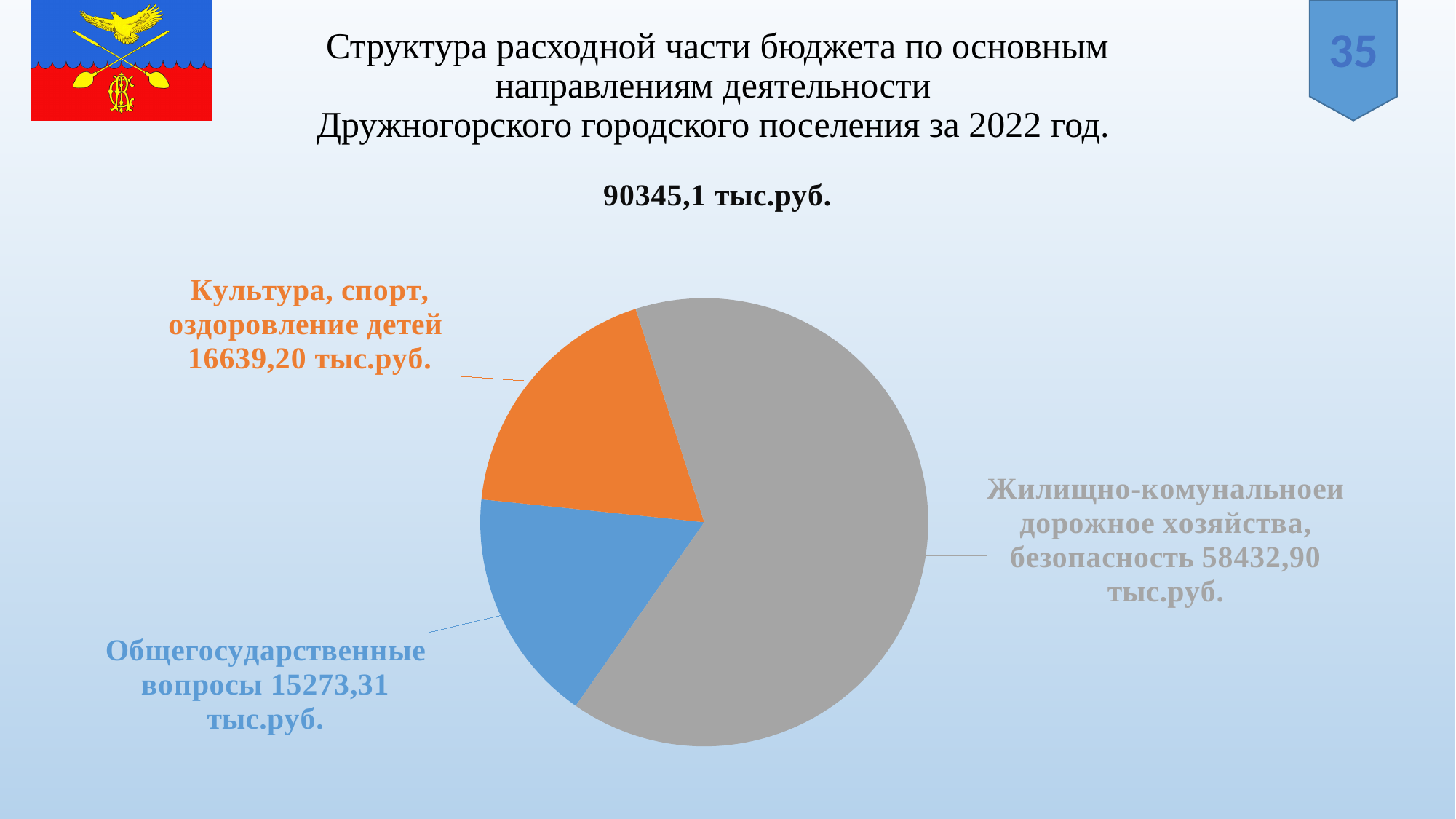
What is the difference between Жилищно-комунальное и дорожное хозяйства, безопасность and Культура, спорт, оздоровление детей? 41793,70 тыс.руб. What total amount is shown above the pie chart? 90345,1 тыс.руб. What kind of chart is shown on the slide? pie chart Which category has the smallest slice of the pie? Общегосударственные вопросы What is the value for Общегосударственные вопросы? 15273,31 тыс.руб. What is the difference between Культура, спорт, оздоровление детей and Общегосударственные вопросы? 1365,89 тыс.руб. Which category has the largest slice of the pie? Жилищно-комунальное и дорожное хозяйства, безопасность What is the value for Жилищно-комунальное и дорожное хозяйства, безопасность? 58432,90 тыс.руб. How many slices does the pie chart have? 3 Which is larger: Культура, спорт, оздоровление детей or Общегосударственные вопросы? Культура, спорт, оздоровление детей What is the value for Культура, спорт, оздоровление детей? 16639,20 тыс.руб. What colour is the slice for Общегосударственные вопросы? blue